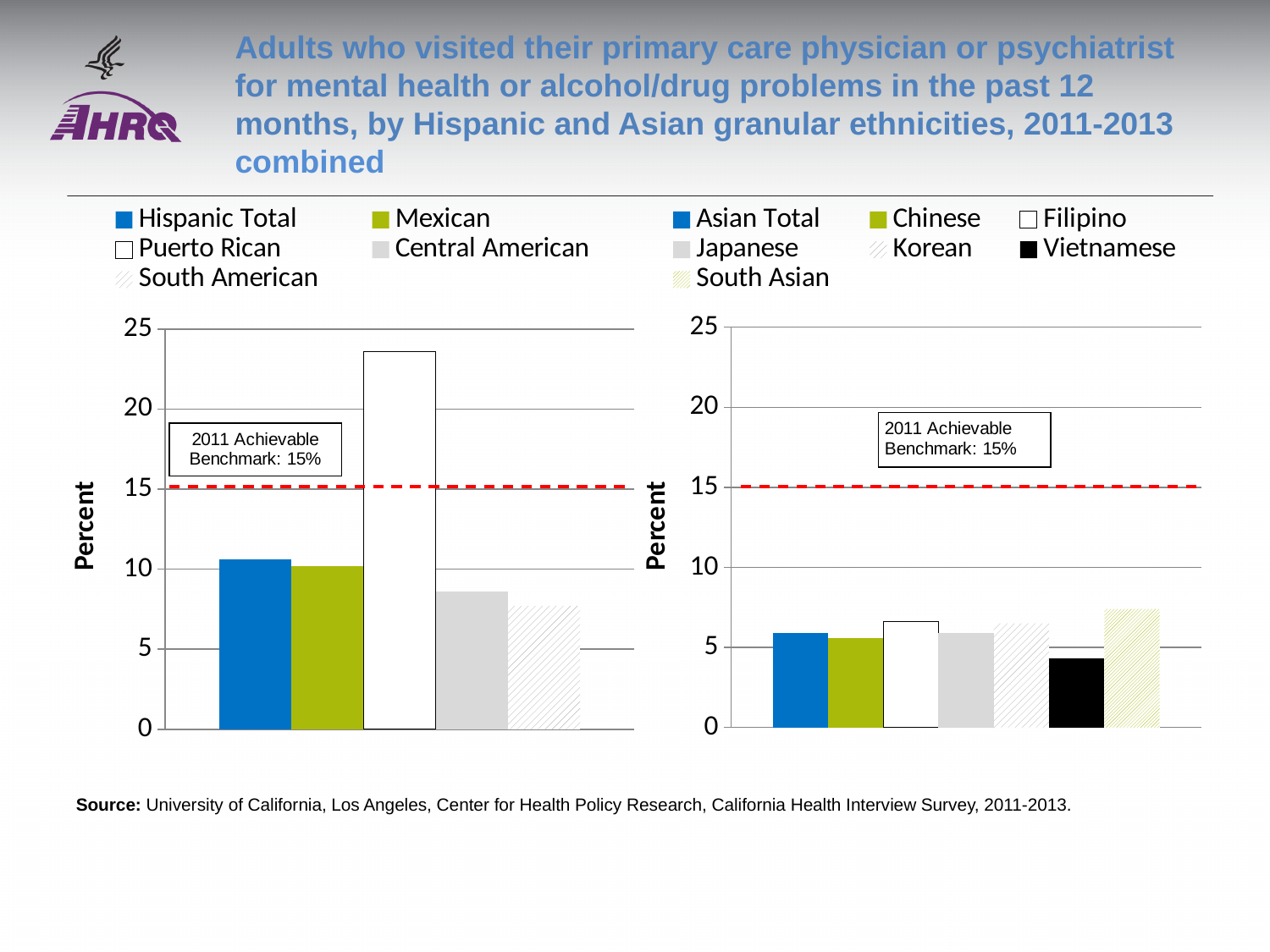
In the left (Hispanic) chart, is the value for Hispanic Total greater or less than 10? greater How many series does the legend of the right (Asian) chart list? 7 In the left (Hispanic) chart, which is larger, the value for Puerto Rican or the value for Mexican? Puerto Rican What kind of chart is the left chart on the slide? bar chart How many series does the legend of the left (Hispanic) chart list? 5 In the left (Hispanic) chart, is the value for Puerto Rican greater or less than 20? greater In the left (Hispanic) chart, which group has the lowest value? South American In the left (Hispanic) chart, which group has the highest value? Puerto Rican In the right (Asian) chart, is the value for South Asian greater or less than 5? greater What is the 2011 Achievable Benchmark shown on the charts? 15% In the right (Asian) chart, which group has the lowest value? Vietnamese